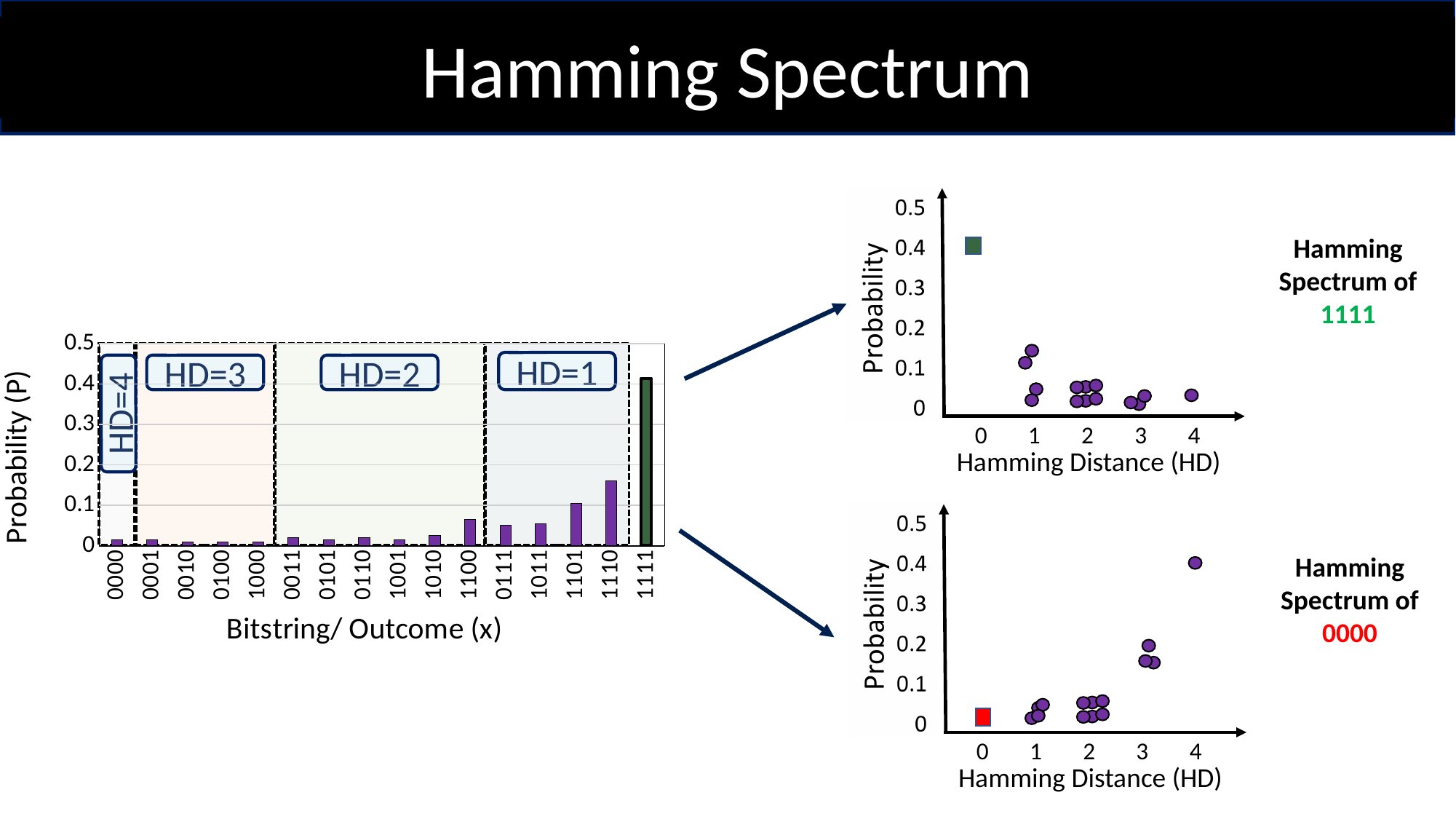
In the left bar chart, how many bitstrings are listed along the x axis? 16 In the 'Hamming Spectrum of 1111' chart, is the point at Hamming Distance 0 greater or less than 0.3? greater In the left bar chart, is the value for 1111 greater or less than 0.3? greater In the left bar chart, is the value for 1110 greater or less than 0.1? greater In the left bar chart, which has the larger probability, 0111 or 1111? 1111 What kind of chart is the chart on the left of the slide, with Bitstring/ Outcome (x) on the x axis? bar chart In the left bar chart, which has the larger probability, 1110 or 1101? 1110 In the left bar chart, do the probabilities generally rise or fall moving from left to right along the x axis? rise What is the x-axis title of the two charts on the right of the slide? Hamming Distance (HD) In the left bar chart, which bitstring has the highest probability? 1111 In the 'Hamming Spectrum of 0000' chart, at which Hamming Distance is the highest probability point located? 4